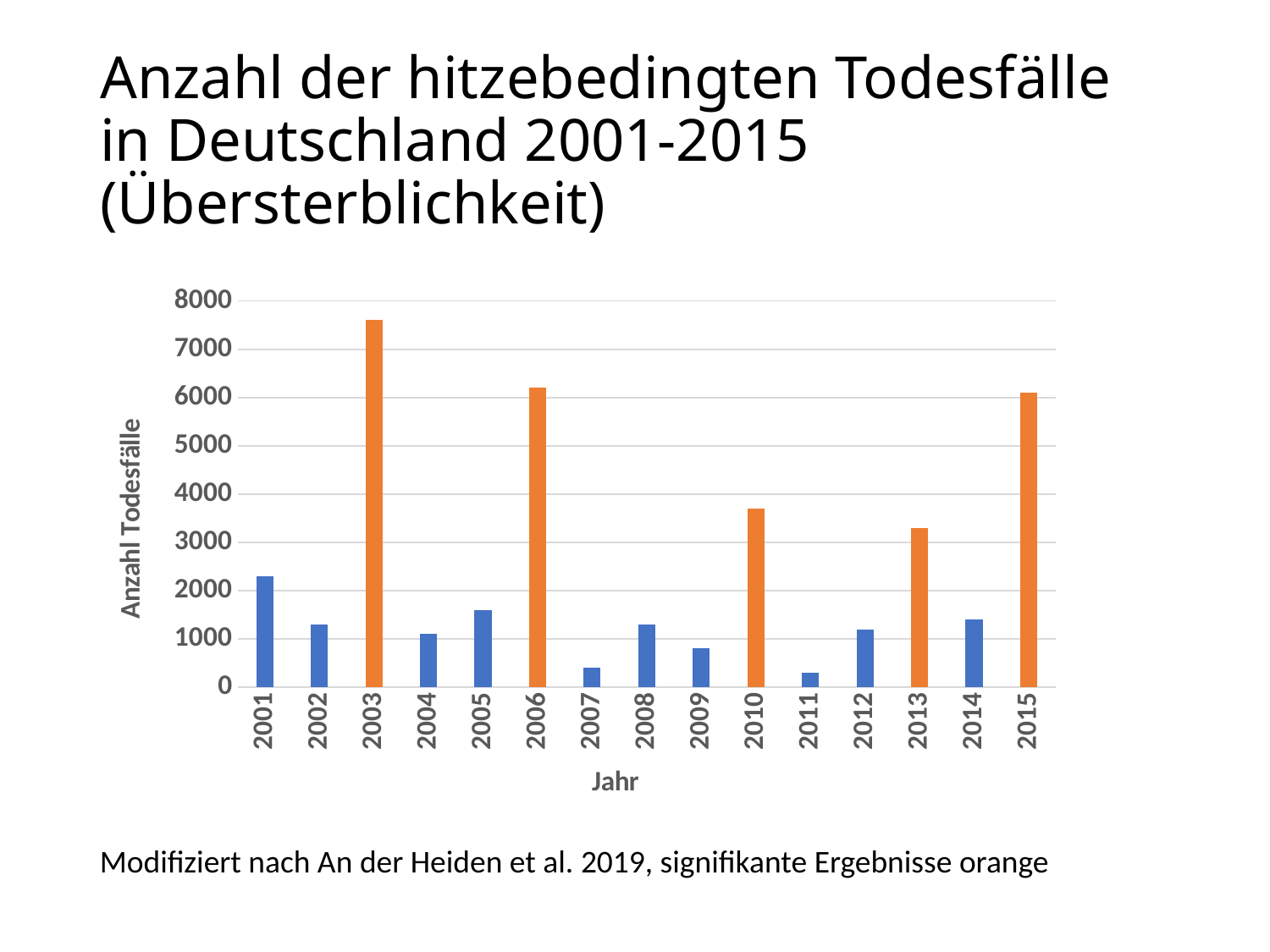
Is the value for 2007 greater or less than 1000? less Is the value for 2001 greater or less than 2000? greater Is the value for 2010 greater or less than 4000? less What kind of chart is shown on the slide? bar chart Which year has the larger value, 2003 or 2006? 2003 Which year has the highest number of heat-related deaths in the chart? 2003 Which year has the larger value, 2010 or 2014? 2010 How many years are plotted on the x axis of the chart? 15 What is the title of the y axis of the chart? Anzahl Todesfälle